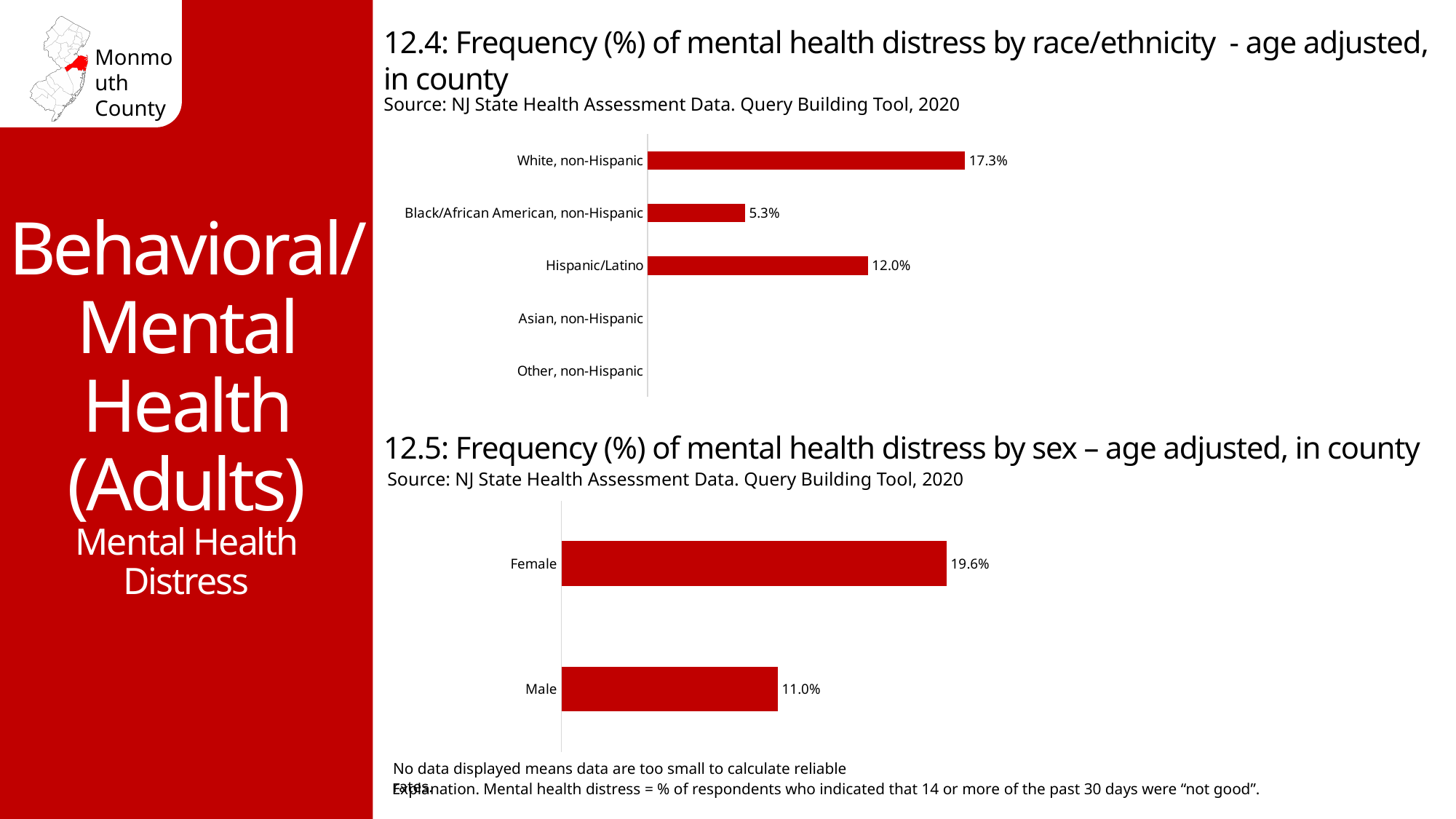
In the chart 12.4 (mental health distress by race/ethnicity), what is the value for Black/African American, non-Hispanic? 5.3% In the chart 12.4 (mental health distress by race/ethnicity), what is the difference between the White, non-Hispanic and Hispanic/Latino values? 5.3% In the chart 12.5 (mental health distress by sex), what is the value for Male? 11.0% In the chart 12.5 (mental health distress by sex), what is the difference between the Female and Male values? 8.6% In the chart 12.5 (mental health distress by sex), which is larger, the Female value or the Male value? Female In the chart 12.4 (mental health distress by race/ethnicity), which categories have no bar displayed? Asian, non-Hispanic and Other, non-Hispanic In the chart 12.4 (mental health distress by race/ethnicity), what is the value for White, non-Hispanic? 17.3% In the chart 12.4 (mental health distress by race/ethnicity), what is the value for Hispanic/Latino? 12.0% What kind of chart is chart 12.5 (mental health distress by sex)? Bar chart In the chart 12.4 (mental health distress by race/ethnicity), which race/ethnicity group has the highest value? White, non-Hispanic In the chart 12.5 (mental health distress by sex), what is the value for Female? 19.6% In the chart 12.4 (mental health distress by race/ethnicity), how many race/ethnicity categories are listed on the axis? 5